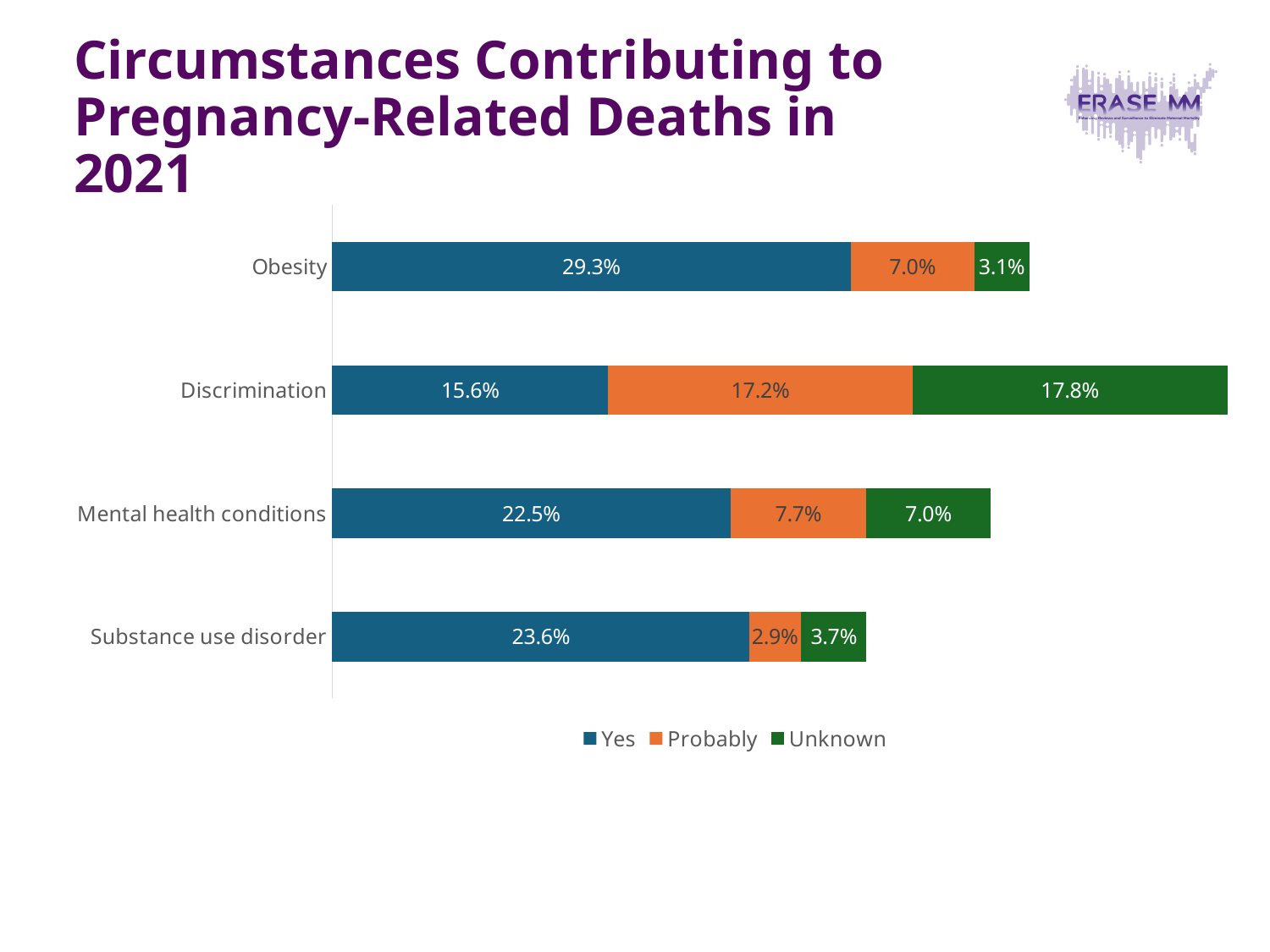
How many series does the legend list? 3 What is the 'Probably' value for Substance use disorder? 2.9% How many categories are shown on the chart? 4 Which series is shown in green in the legend? Unknown What is the 'Unknown' value for Discrimination? 17.8% Which category has the highest 'Yes' value? Obesity What is the difference between the 'Yes' values for Substance use disorder and Mental health conditions? 1.1% What is the total of the stacked bar for Discrimination? 50.6% Which is larger, the 'Unknown' value for Mental health conditions or the 'Unknown' value for Obesity? Mental health conditions What kind of chart is shown on the slide? Stacked bar chart What is the 'Yes' value for Obesity? 29.3% Which category has the lowest 'Probably' value? Substance use disorder